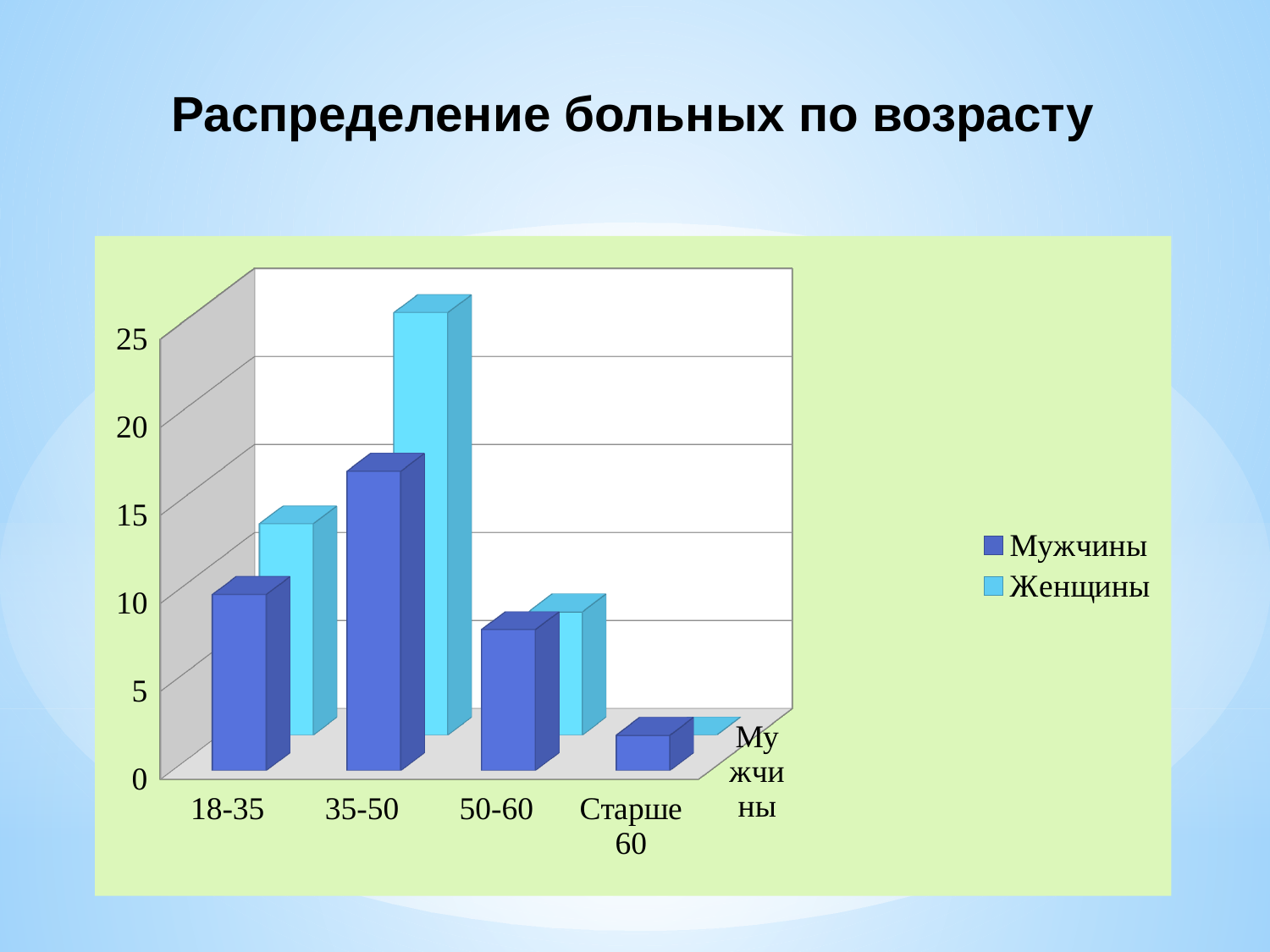
Is the value for Мужчины in the 35-50 category greater or less than 15? greater Which age category has the highest value for Женщины? 35-50 Is the value for Мужчины in the Старше 60 category greater or less than 5? less How many age categories are shown on the x axis? 4 What kind of chart is shown on the slide? Bar chart In the Старше 60 category, which series has the larger value, Мужчины or Женщины? Мужчины Which age category has the highest value for Мужчины? 35-50 Which age category has the lowest value for Мужчины? Старше 60 How many series does the legend list? 2 Is the value for Женщины in the 35-50 category greater or less than 20? greater In the 35-50 category, which series has the larger value, Мужчины or Женщины? Женщины What is the title of the chart? Распределение больных по возрасту